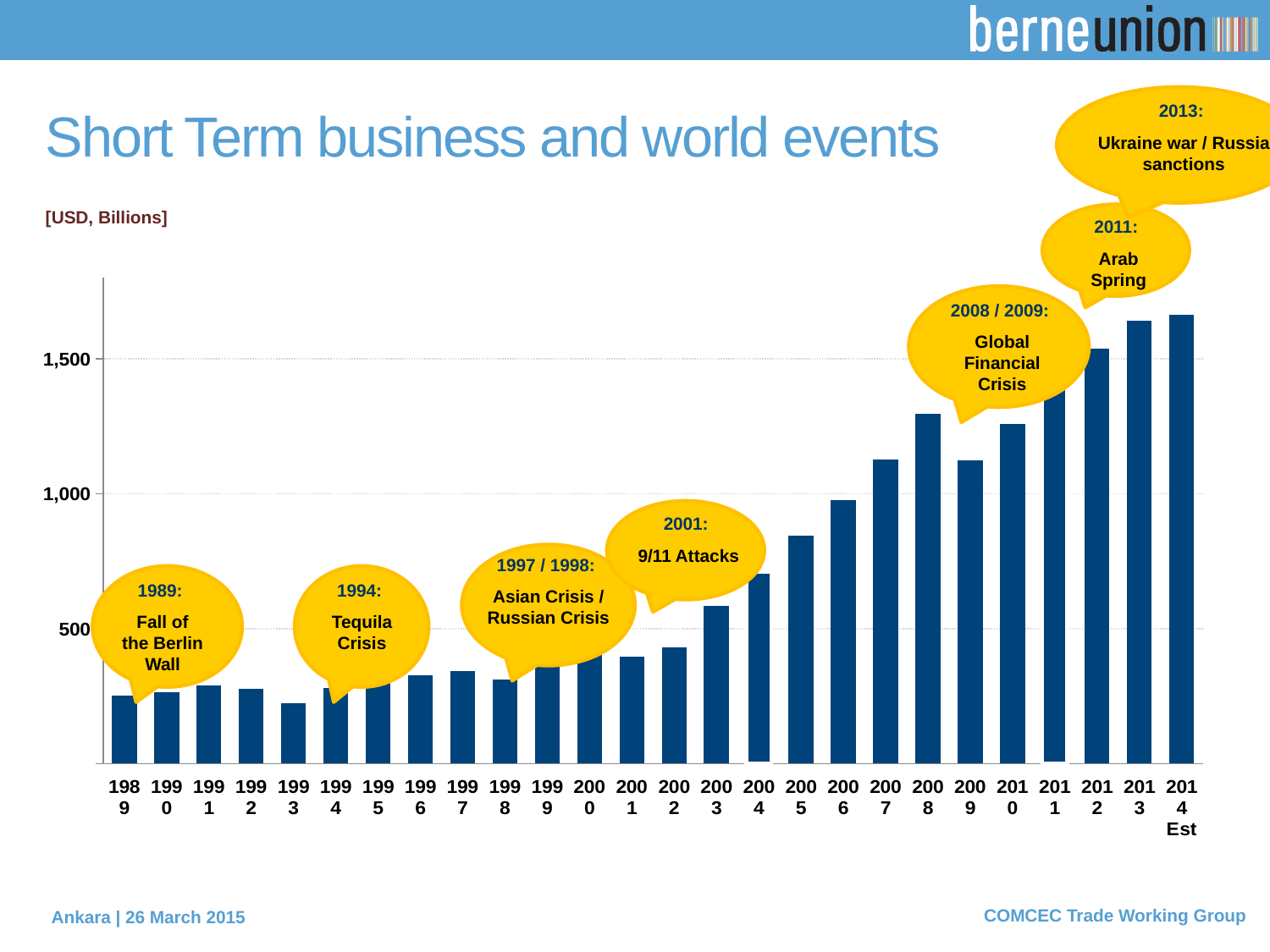
Which is larger, the value for 2008 or the value for 2009? 2008 How many years (bars) are plotted on the chart? 26 Is the value for 2002 greater or less than 500? less Is the value for 2005 greater or less than 1,000? less What kind of chart is shown on the slide? bar chart What unit is given for the values on the chart? [USD, Billions] Which year has the lowest value on the chart? 1993 Is the value for 2003 greater or less than 500? greater Do the values generally rise or fall from 1989 to 2014 Est? rise Which world event does the callout for 2001 name? 9/11 Attacks